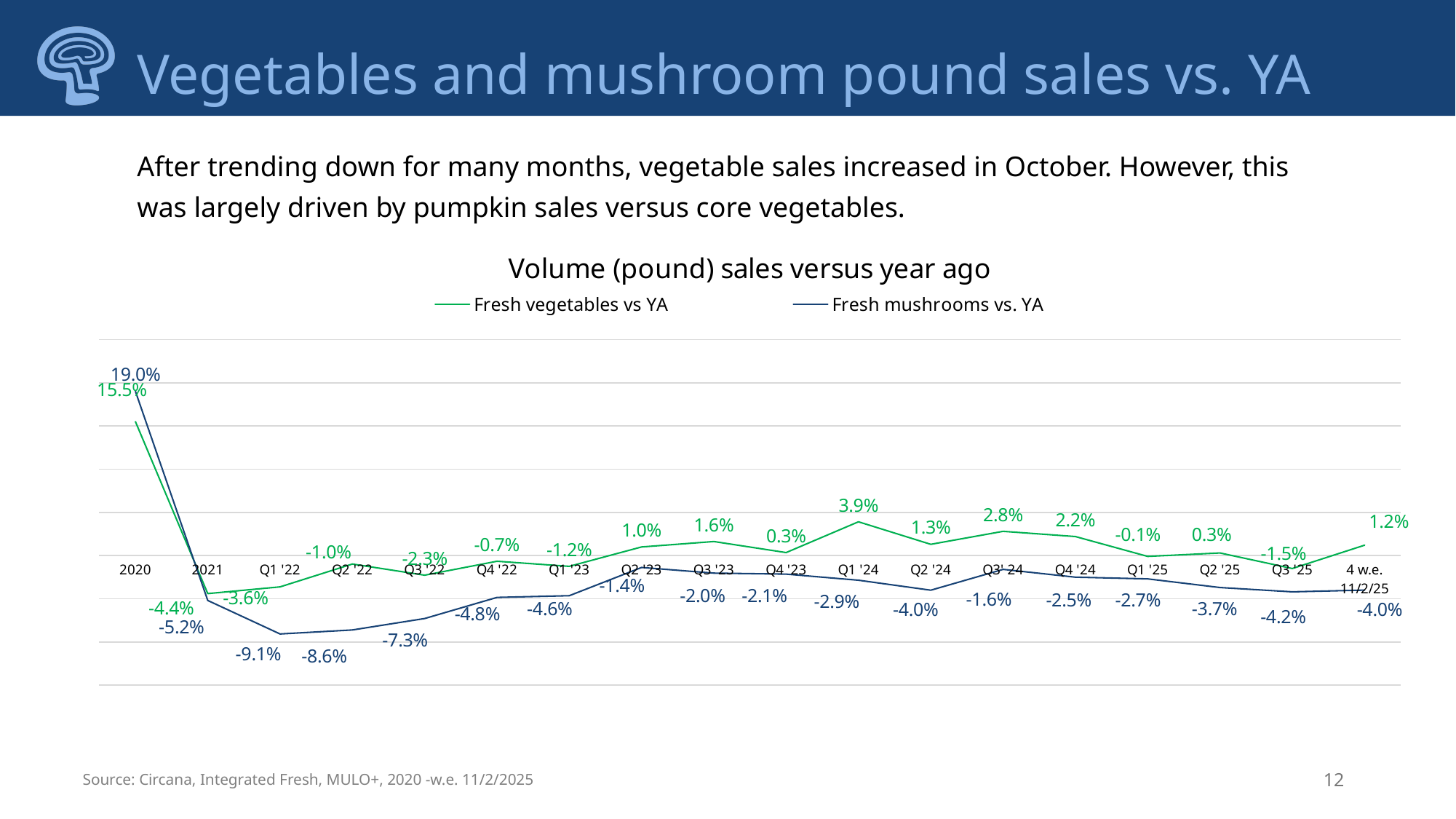
Which period has the lowest value for Fresh mushrooms vs. YA? Q1 '22 Which period has the highest value for Fresh vegetables vs YA? 2020 What is the title of the chart? Volume (pound) sales versus year ago What is the difference between the Fresh vegetables vs YA value and the Fresh mushrooms vs. YA value in Q3 '25? 2.7 percentage points What is the value for Fresh mushrooms vs. YA in 2020? 19.0% What type of chart is shown on the slide? line chart What is the value for Fresh vegetables vs YA in Q1 '24? 3.9% What is the value for Fresh vegetables vs YA for the 4 w.e. 11/2/25 period? 1.2% How many series does the legend list? 2 How many time periods are plotted on the x axis? 18 What is the value for Fresh mushrooms vs. YA in Q1 '22? -9.1% In Q2 '24, which series has the larger value, Fresh vegetables vs YA or Fresh mushrooms vs. YA? Fresh vegetables vs YA